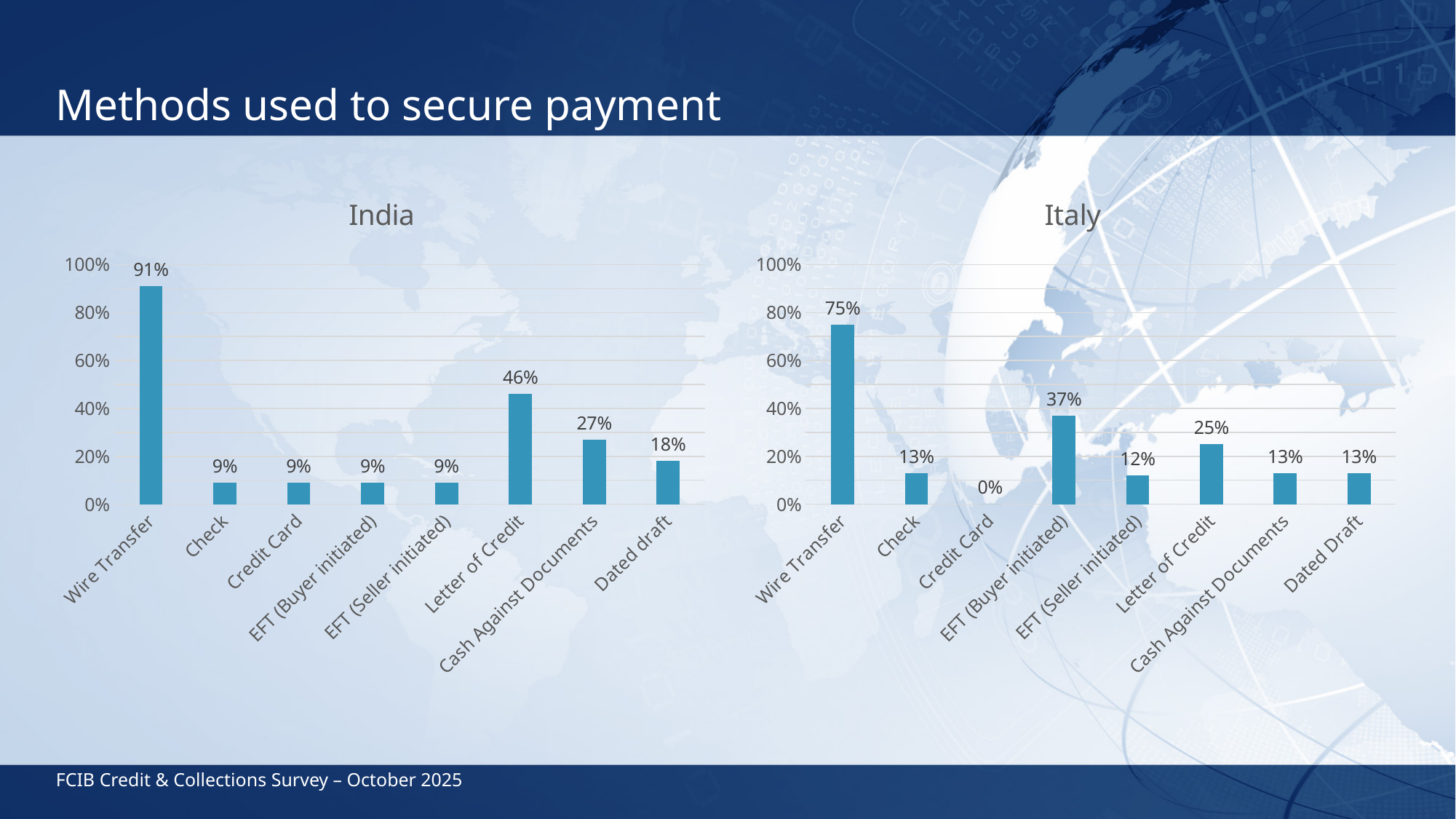
In the India chart, which category has the highest value? Wire Transfer In the India chart, what is the difference between Letter of Credit and Cash Against Documents? 19% How many categories are shown in the Italy chart? 8 In the Italy chart, which category has the lowest value? Credit Card In the Italy chart, what is the value for Credit Card? 0% In the Italy chart, what is the value for EFT (Buyer initiated)? 37% Which is larger: Letter of Credit in the India chart or Letter of Credit in the Italy chart? India What is the title of the chart on the right side of the slide? Italy In the India chart, is the value for Dated draft greater or less than 20%? less In the Italy chart, what is the difference between Wire Transfer and Letter of Credit? 50% In the India chart, what is the value for Wire Transfer? 91% What kind of chart is the India chart? bar chart